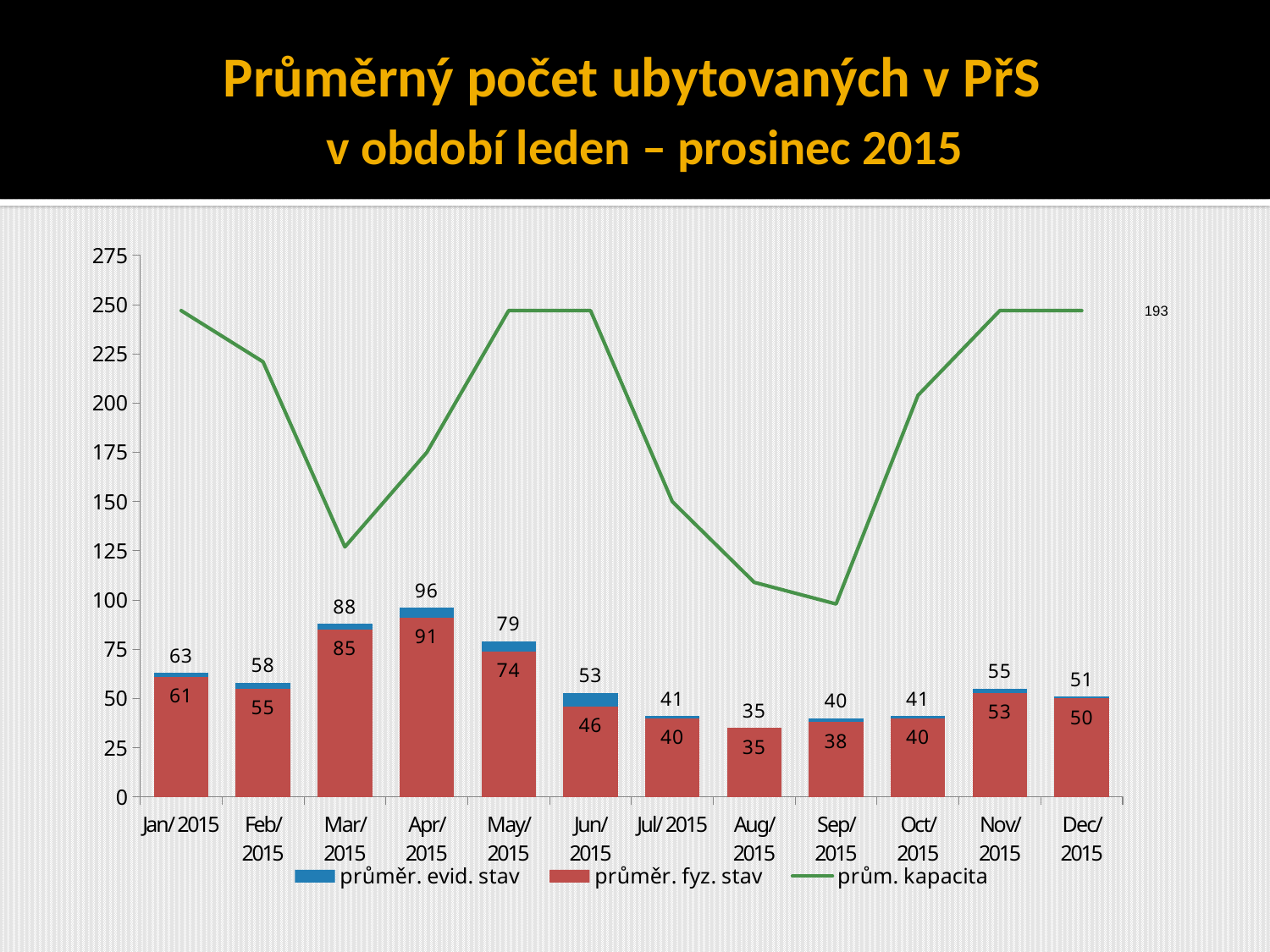
Which is larger, the průměr. fyz. stav value for Jan/2015 or for Nov/2015? Jan/2015 Is the prům. kapacita value for Mar/2015 greater or less than 150? less What is the value of průměr. fyz. stav for May/2015? 74 What is the value of průměr. evid. stav for Apr/2015? 96 Is the prům. kapacita value for Jun/2015 greater or less than 225? greater What is the difference between the průměr. evid. stav values for Mar/2015 and Feb/2015? 30 What colour represents the prům. kapacita series? green Does the prům. kapacita line rise or fall from Jul/2015 to Sep/2015? fall How many series does the legend list? 3 How many months are shown on the x axis? 12 Which month has the lowest průměr. fyz. stav value? Aug/2015 Which month has the highest průměr. evid. stav value? Apr/2015